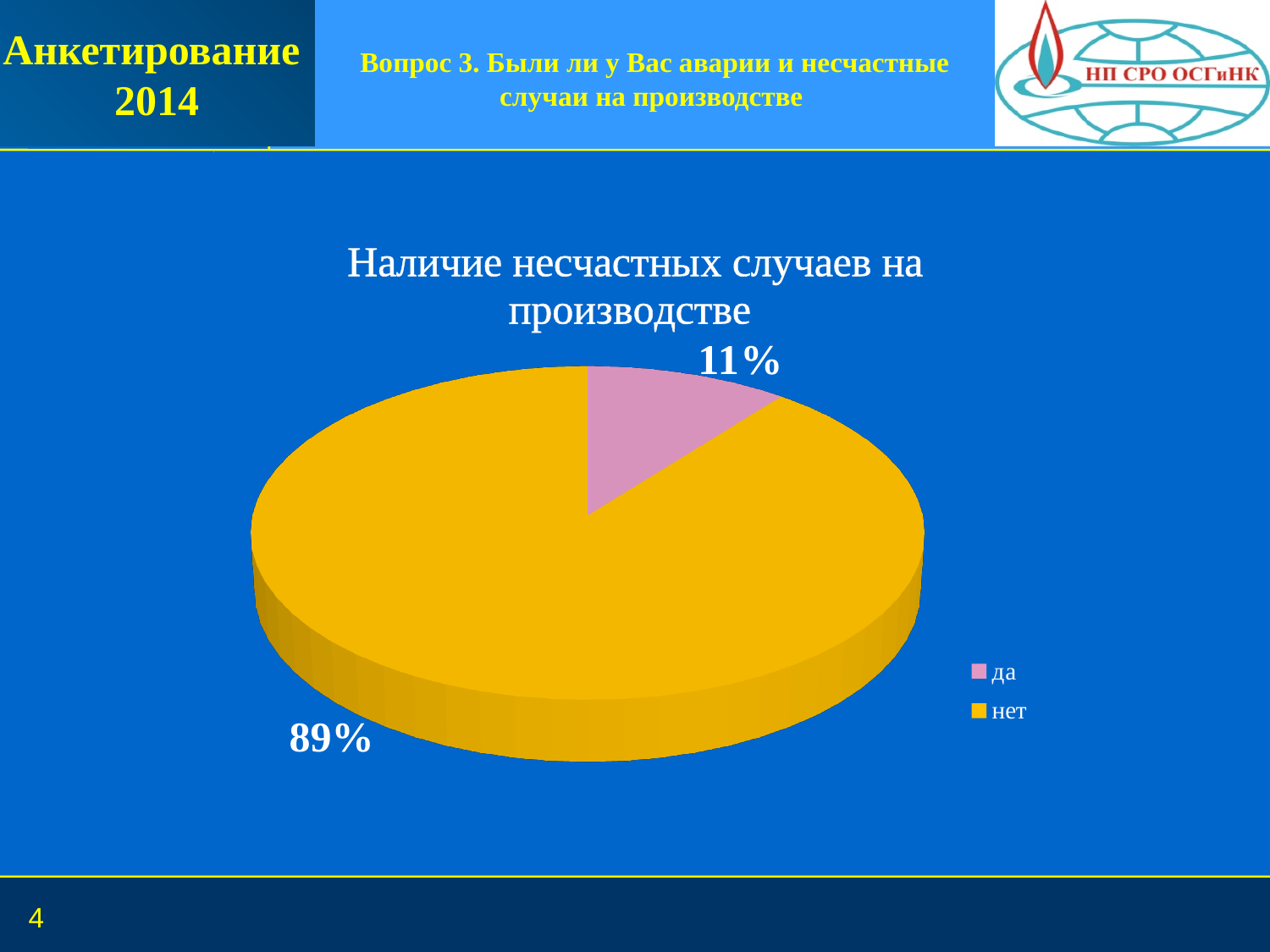
Which slice is the smallest? да Which is larger, the "да" slice or the "нет" slice? нет How many entries does the legend list? 2 Which slice is the largest? нет What colour is the "нет" slice? yellow What share of the pie does the "да" slice represent? 11% What is the title of the chart? Наличие несчастных случаев на производстве How many slices does the pie chart have? 2 What is the difference in percentage points between the "нет" and "да" slices? 78 What percentage is shown for the "нет" slice? 89% What kind of chart is shown on the slide? pie chart What percentage is shown for the "да" slice? 11%